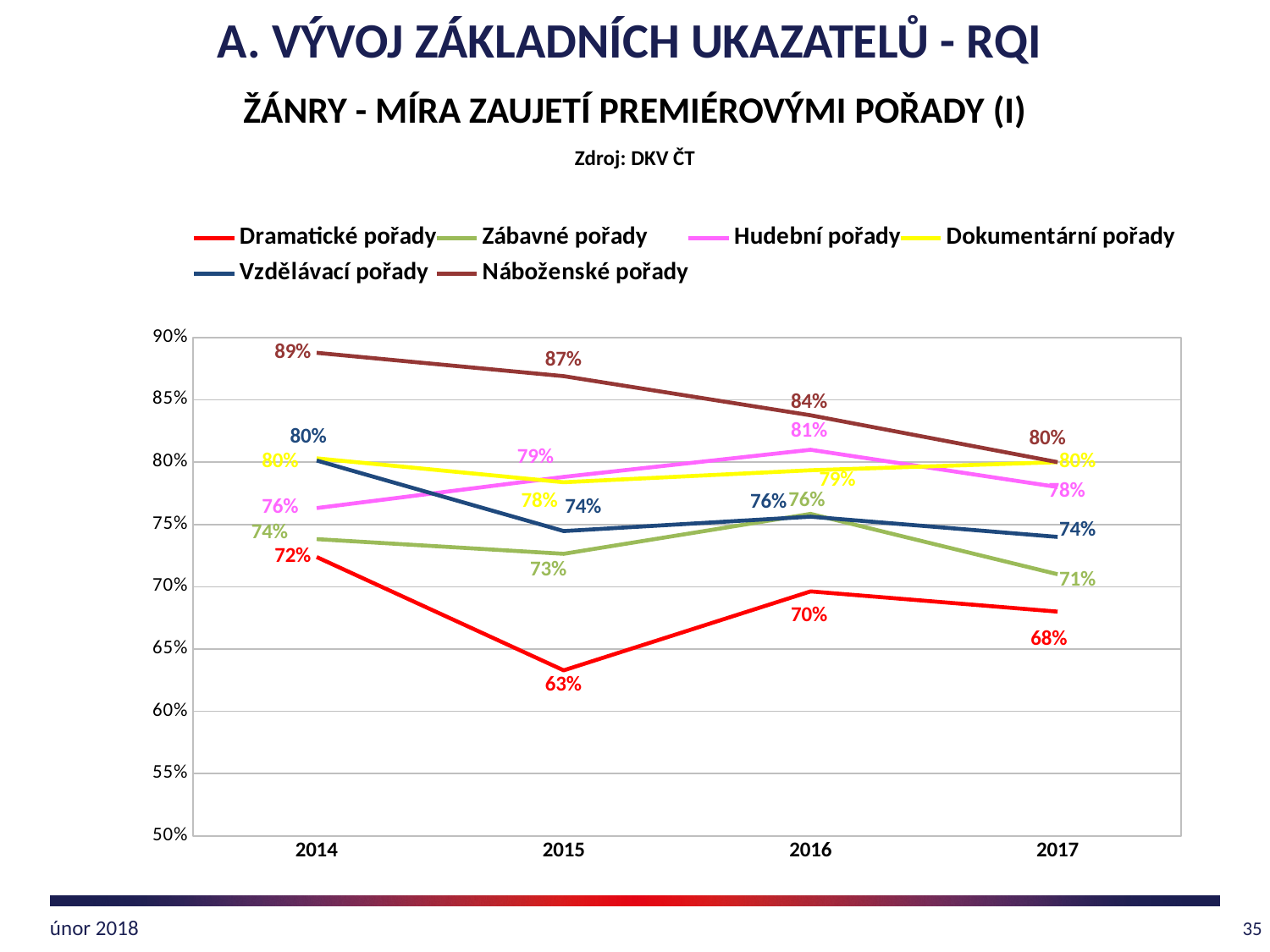
Does the Náboženské pořady line rise or fall from 2014 to 2017? It falls What is the value for Dokumentární pořady in 2015? 78% In 2017, which is higher: Zábavné pořady or Vzdělávací pořady? Vzdělávací pořady How many series does the legend list? 6 Which series has the lowest value in 2015? Dramatické pořady How many years are shown on the x axis? 4 Which series has the highest value in 2016? Náboženské pořady What is the value for Dramatické pořady in 2015? 63% What kind of chart is shown on the slide? Line chart What is the value for Náboženské pořady in 2014? 89% By how many percentage points did Náboženské pořady fall from 2014 to 2017? 9 percentage points What is the value for Hudební pořady in 2016? 81%